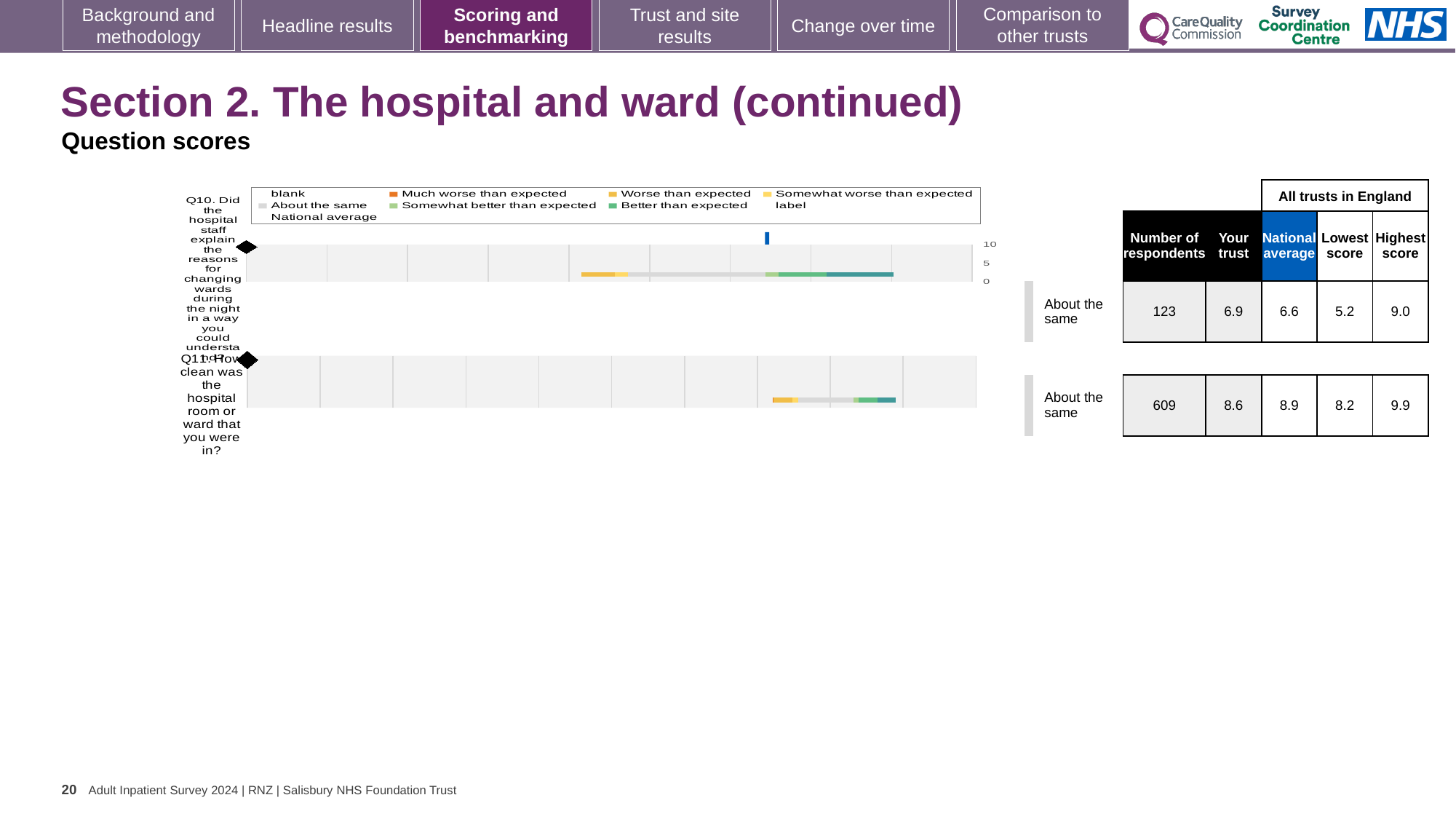
What benchmark category is shown for Q11? About the same What is the 'Your trust' score for Q11 (how clean was the hospital room or ward)? 8.6 What is the national average score for Q11? 8.9 For Q11, which is higher: the 'Your trust' score or the national average? National average For Q10, which is higher: the 'Your trust' score or the national average? Your trust Which question has the higher 'Your trust' score, Q10 or Q11? Q11 What kind of chart is used to show the question scores for Q10 and Q11? bar chart What is the difference between the highest score and the lowest score for Q11? 1.7 How many questions are plotted in the chart? 2 What is the national average score for Q10? 6.6 What is the difference between the highest score and the lowest score for Q10? 3.8 What is the 'Your trust' score for Q10 (explaining reasons for changing wards during the night)? 6.9